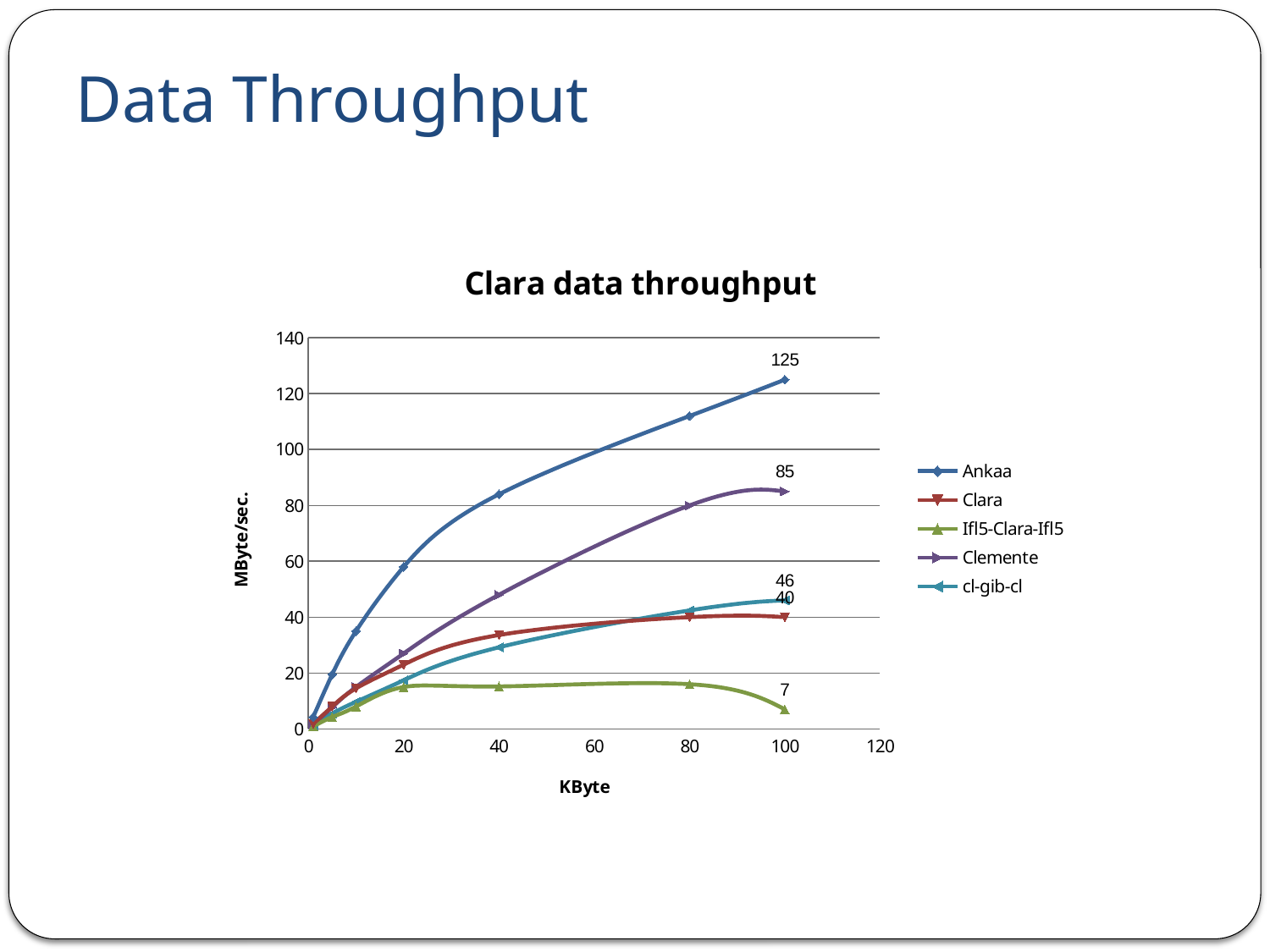
Is the value for Ankaa at 80 KByte greater or less than 100? greater What is the value for cl-gib-cl at 100 KByte? 46 Does the Ankaa series rise or fall as KByte increases? rise What is the value for Clemente at 100 KByte? 85 What is the title of the chart? Clara data throughput Which series has the highest value at 100 KByte? Ankaa What is the value for Ankaa at 100 KByte? 125 How many series does the legend list? 5 What is the difference between the Ankaa and Clemente values at 100 KByte? 40 What is the value for Ifl5-Clara-Ifl5 at 100 KByte? 7 What type of chart is shown on the slide? line chart Which series has the lowest value at 100 KByte? Ifl5-Clara-Ifl5